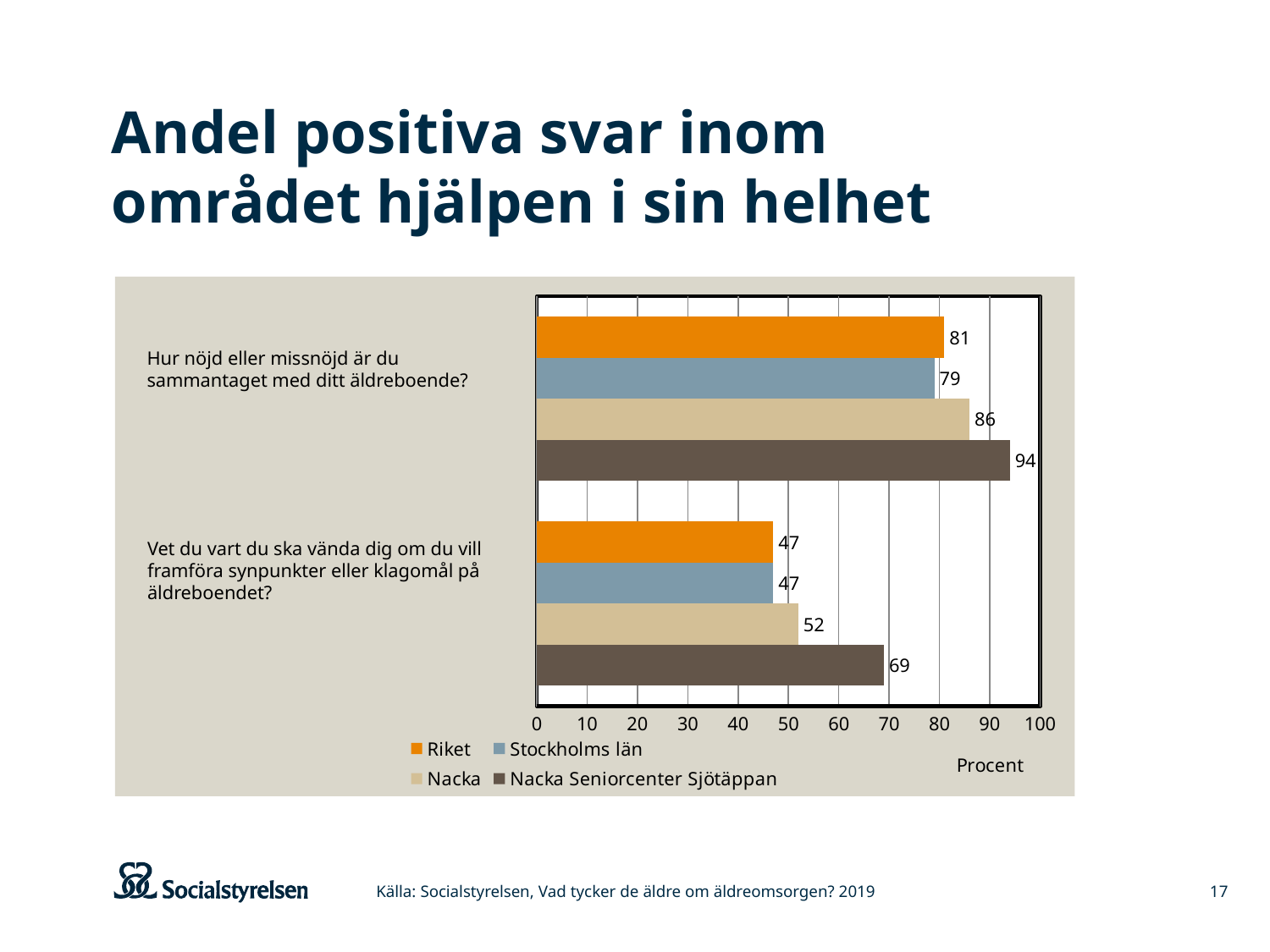
What is the value for Stockholms län for the question "Hur nöjd eller missnöjd är du sammantaget med ditt äldreboende?"? 79 How many series does the legend list? 4 What is the difference between the Nacka Seniorcenter Sjötäppan value and the Nacka value for the question "Vet du vart du ska vända dig om du vill framföra synpunkter eller klagomål på äldreboendet?"? 17 Which series has the highest value for the question "Vet du vart du ska vända dig om du vill framföra synpunkter eller klagomål på äldreboendet?"? Nacka Seniorcenter Sjötäppan Which series has the lowest value for the question "Hur nöjd eller missnöjd är du sammantaget med ditt äldreboende?"? Stockholms län How many questions (categories) are shown on the chart? 2 Which is larger: the Nacka value for "Hur nöjd eller missnöjd är du sammantaget med ditt äldreboende?" or the Riket value for the same question? Nacka What kind of chart is shown on the slide? bar chart What is the value for Riket for the question "Vet du vart du ska vända dig om du vill framföra synpunkter eller klagomål på äldreboendet?"? 47 What is the value for Nacka Seniorcenter Sjötäppan for the question "Hur nöjd eller missnöjd är du sammantaget med ditt äldreboende?"? 94 What is the difference between the Nacka Seniorcenter Sjötäppan value and the Riket value for the question "Hur nöjd eller missnöjd är du sammantaget med ditt äldreboende?"? 13 What is the value for Nacka for the question "Vet du vart du ska vända dig om du vill framföra synpunkter eller klagomål på äldreboendet?"? 52